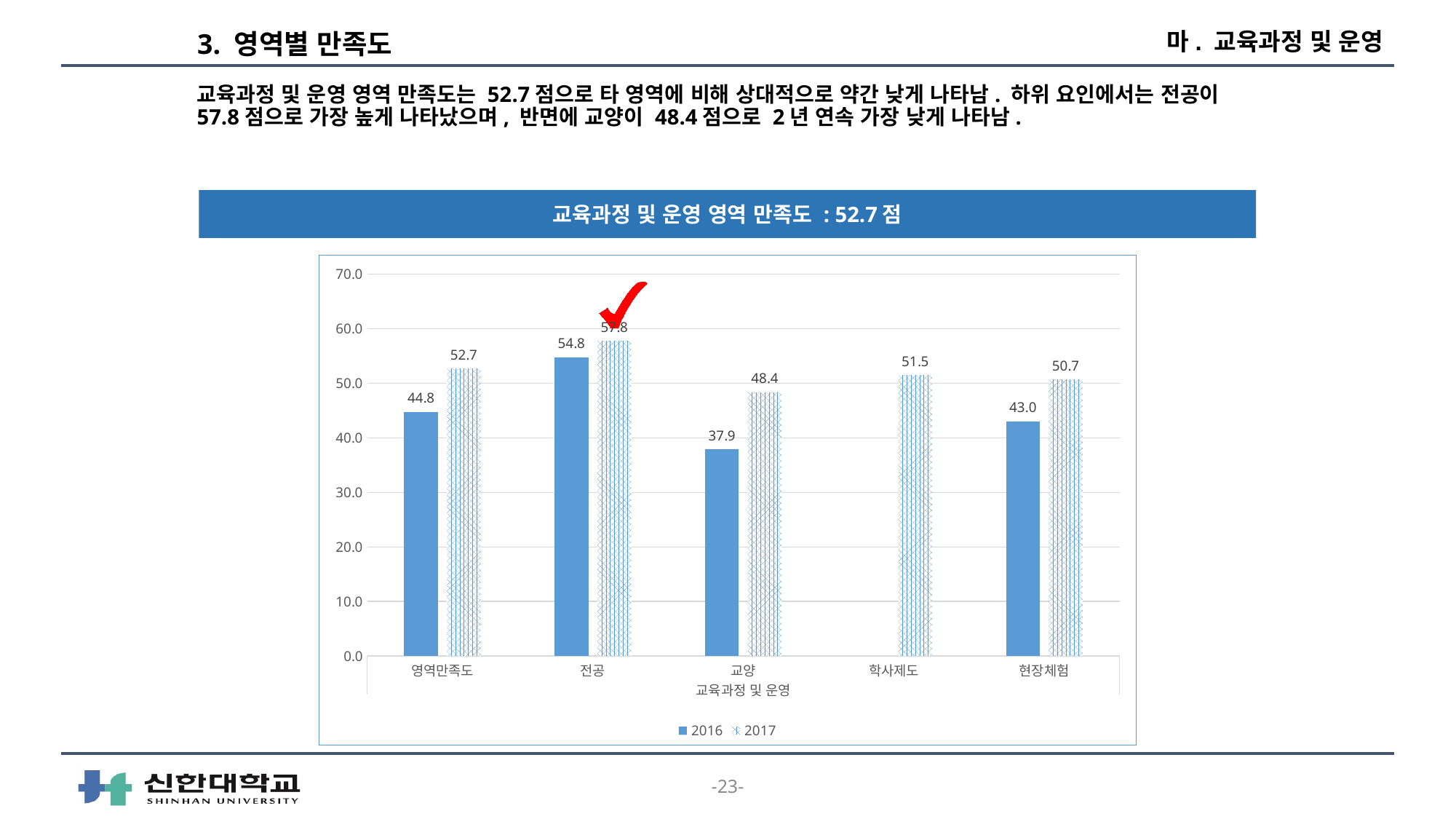
Is the 2017 value for 현장체험 greater or less than 50.0? greater How many categories are shown on the x axis? 5 What is the 2016 value for 현장체험? 43.0 What kind of chart is shown on the slide? bar chart How many series does the legend list? 2 What is the 2016 value for 교양? 37.9 What is the difference between the 2017 and 2016 values for 교양? 10.5 What is the 2017 value for 전공? 57.8 Which is larger, the 2016 value for 영역만족도 or the 2016 value for 현장체험? 영역만족도 Which category has the highest 2017 value? 전공 What is the 2017 value for 학사제도? 51.5 Which category has the lowest 2016 value? 교양